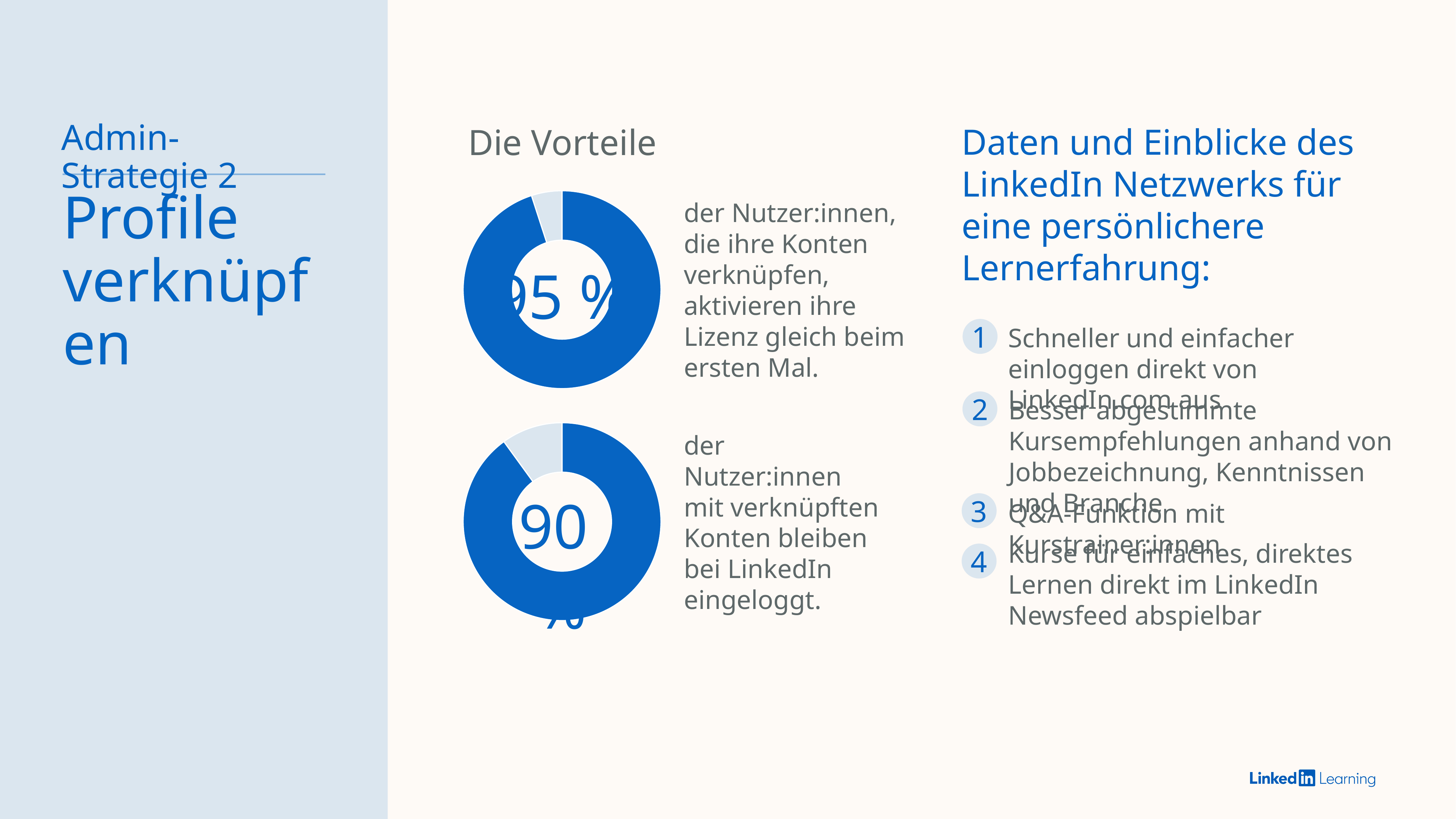
What value is printed in the centre of the upper donut chart? 95 % What colour is the large filled segment in both donut charts? Blue By how many percentage points does the upper donut chart's value exceed the lower donut chart's value? 5 How many donut charts are shown on the slide? 2 Which donut chart shows the larger value, the upper one or the lower one? The upper one How many segments does each donut chart have? 2 Is the value shown in the upper donut chart greater or less than 50 %? greater What kind of chart is used to show the percentages under "Die Vorteile"? Donut (pie) chart What share of the upper donut chart is filled by the dark blue segment? 95 % What is the heading above the two donut charts? Die Vorteile Which donut chart has the larger light grey segment, the upper or the lower one? The lower one What number is printed in the centre of the lower donut chart? 90